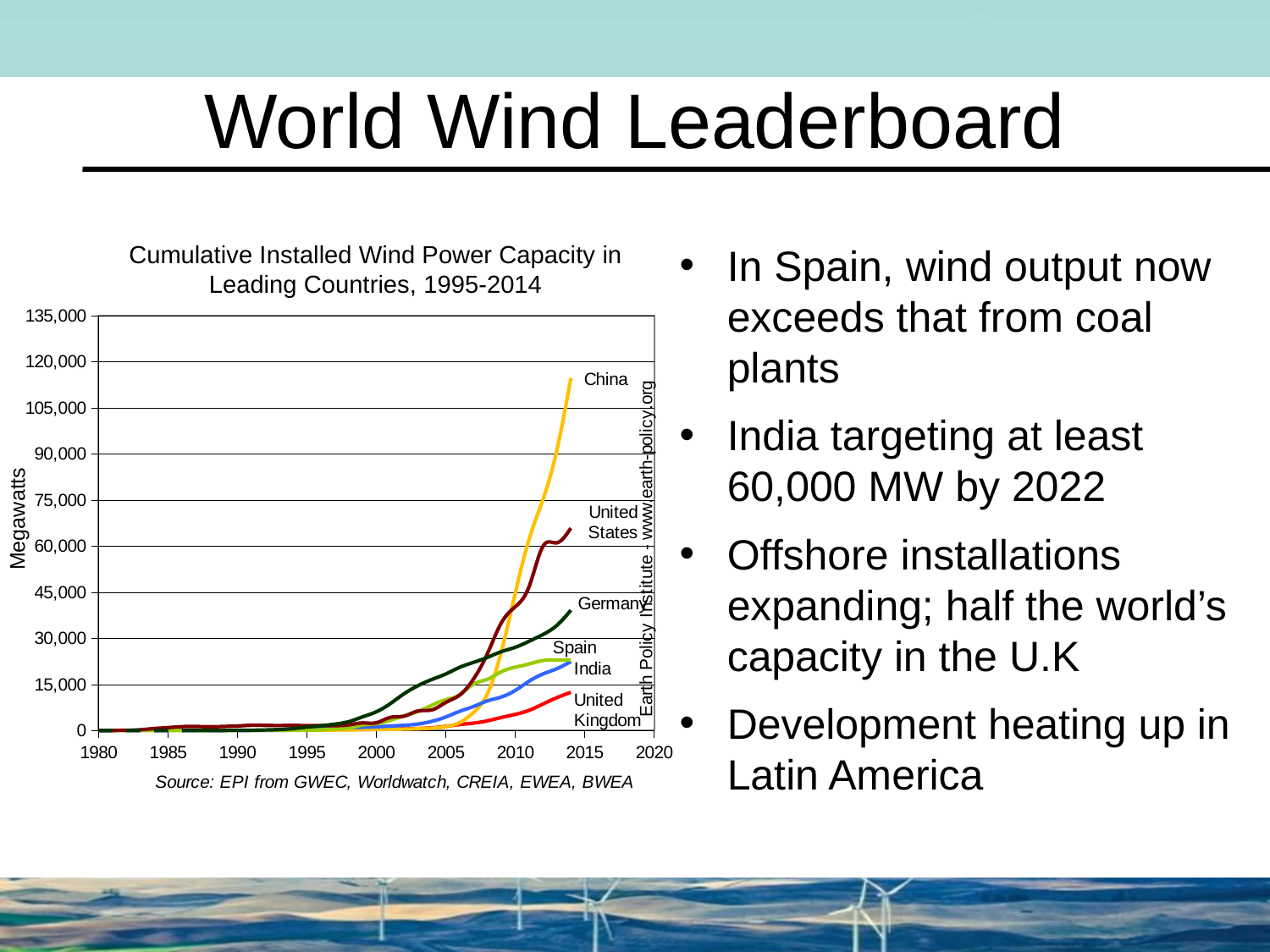
How many countries are plotted as lines on the chart? 6 In 2014, which has the larger installed wind power capacity, China or the United States? China Is the value for the United States in 2014 greater or less than 45,000 megawatts? greater Which country has the lowest cumulative installed wind power capacity in 2014? United Kingdom What kind of chart is shown on the slide? Line chart Is the value for Spain in 2014 greater or less than 30,000 megawatts? less Does China's cumulative installed wind power capacity rise or fall between 2005 and 2014? Rise Is the value for the United Kingdom in 2014 greater or less than 15,000 megawatts? less What is the label on the vertical axis of the chart? Megawatts Which country has the highest cumulative installed wind power capacity in 2014? China